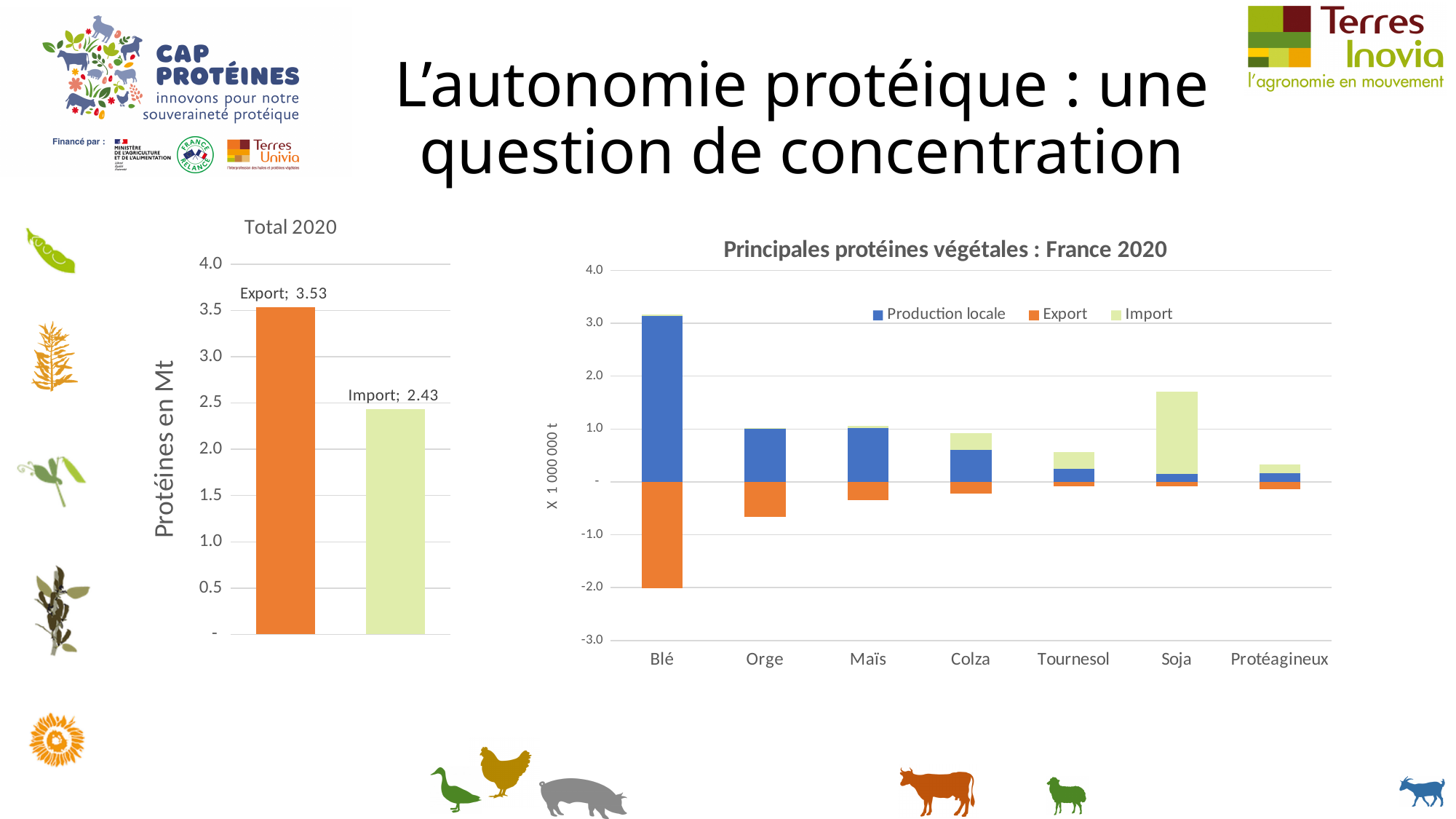
In the 'Total 2020' chart, which is larger, Export or Import? Export In the 'Principales protéines végétales : France 2020' chart, how many categories are shown on the x axis? 7 In the 'Principales protéines végétales : France 2020' chart, which category has the highest Production locale value? Blé What kind of chart is 'Principales protéines végétales : France 2020'? Stacked bar chart In the 'Total 2020' chart, what is the value for Import? 2.43 In the 'Principales protéines végétales : France 2020' chart, is the Production locale value for Blé greater or less than 3.0? greater In the 'Principales protéines végétales : France 2020' chart, is the Export value for Blé greater or less than -1.0? less In the 'Total 2020' chart, what is the value for Export? 3.53 In the 'Total 2020' chart, what is the difference between the Export and Import values? 1.10 In the 'Total 2020' chart, what is the y-axis label? Protéines en Mt In the 'Principales protéines végétales : France 2020' chart, which category has the largest Import value? Soja In the 'Principales protéines végétales : France 2020' chart, how many series does the legend list? 3